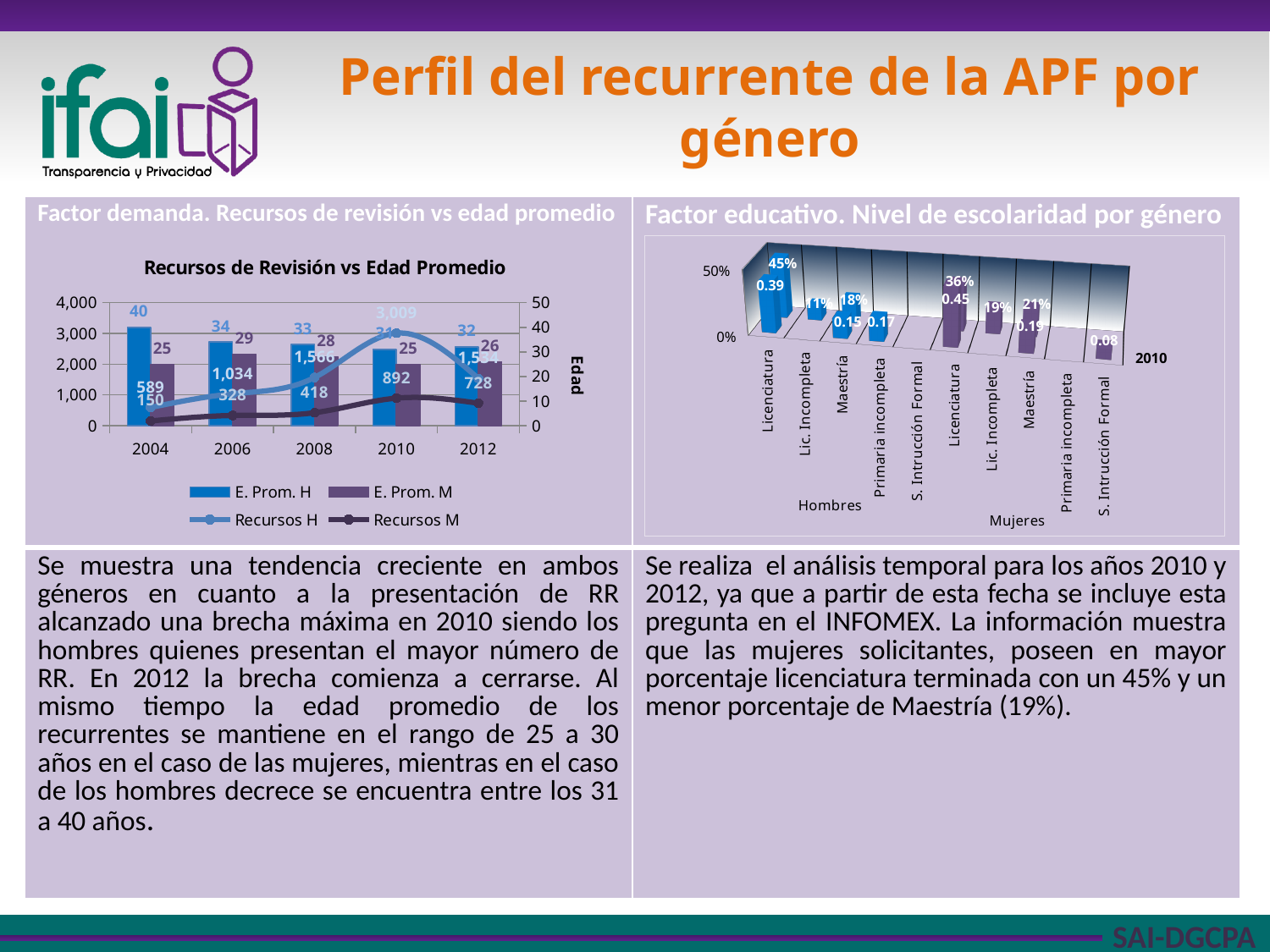
In the chart 'Recursos de Revisión vs Edad Promedio', in which year is Recursos M lowest? 2004 In the chart 'Recursos de Revisión vs Edad Promedio', what is the value of E. Prom. H in 2004? 40 In the chart 'Recursos de Revisión vs Edad Promedio', in which year is Recursos M highest? 2010 In the chart 'Recursos de Revisión vs Edad Promedio', which is larger in 2006, E. Prom. H or E. Prom. M? E. Prom. H In the chart 'Recursos de Revisión vs Edad Promedio', what is the value of E. Prom. M in 2006? 29 In the chart 'Recursos de Revisión vs Edad Promedio', how many years are shown on the x axis? 5 What kind of chart is the 'Factor educativo. Nivel de escolaridad por género' chart on the right? 3D bar chart In the chart 'Recursos de Revisión vs Edad Promedio', what is the value of Recursos M in 2010? 892 In the chart 'Recursos de Revisión vs Edad Promedio', what is the difference between Recursos H and Recursos M in 2004? 439 In the chart 'Recursos de Revisión vs Edad Promedio', does Recursos M rise or fall from 2004 to 2010? rise In the chart 'Recursos de Revisión vs Edad Promedio', what is the value of Recursos H in 2006? 1,034 In the chart 'Recursos de Revisión vs Edad Promedio', how many series does the legend list? 4